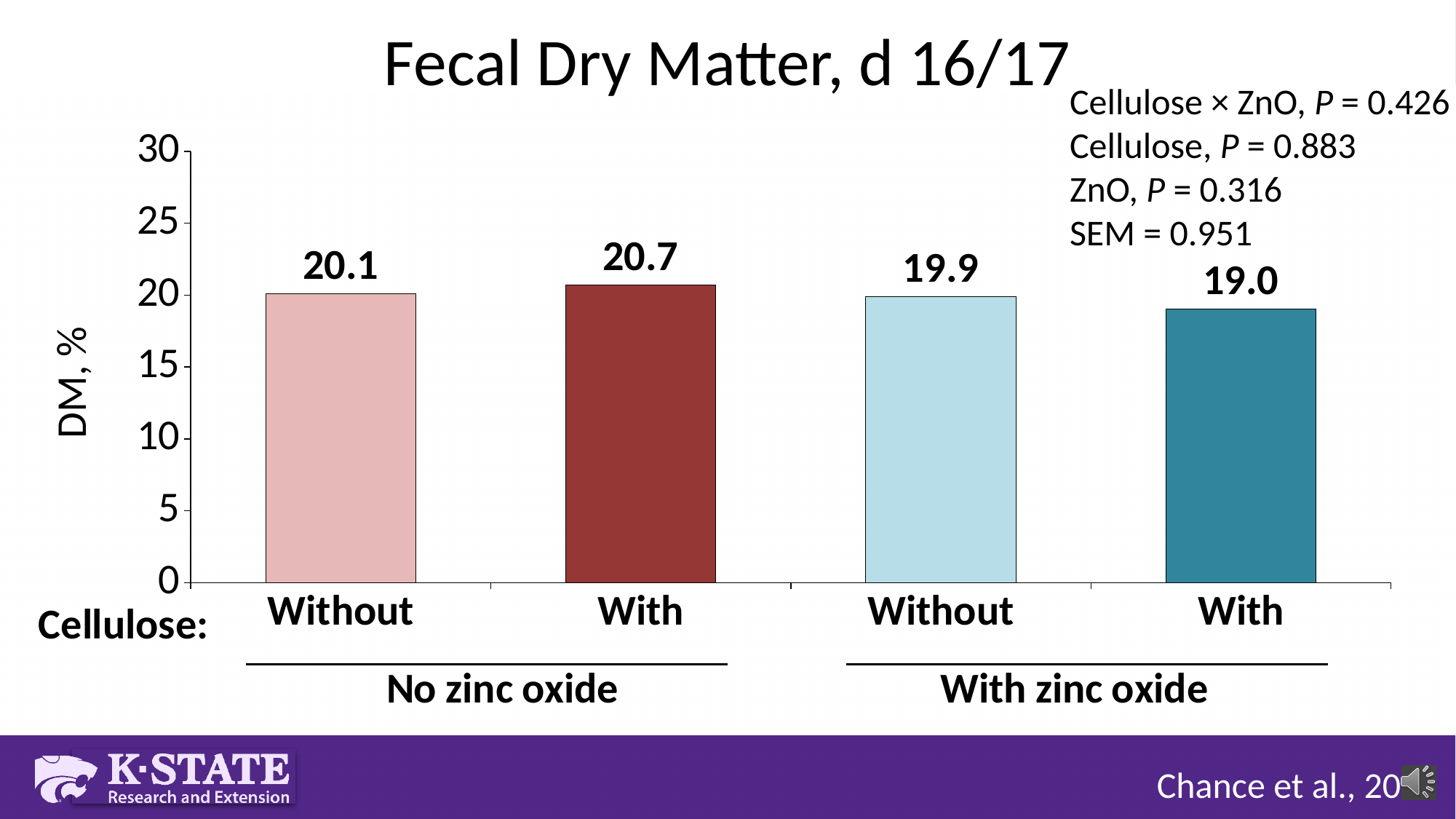
What is the fecal dry matter value for the Without cellulose bar in the No zinc oxide group? 20.1 What is the label of the y axis? DM, % How many bars are plotted in the chart? 4 What is the fecal dry matter value for the Without cellulose bar in the With zinc oxide group? 19.9 What is the fecal dry matter value for the With cellulose bar in the No zinc oxide group? 20.7 Which is larger: the With cellulose bar in the No zinc oxide group or the With cellulose bar in the With zinc oxide group? With cellulose, No zinc oxide What is the difference between the With cellulose and Without cellulose bars in the No zinc oxide group? 0.6 What kind of chart is shown on the slide? Bar chart What is the fecal dry matter value for the With cellulose bar in the With zinc oxide group? 19.0 Which bar has the lowest fecal dry matter value? With cellulose, With zinc oxide Which bar has the highest fecal dry matter value? With cellulose, No zinc oxide What is the difference between the Without cellulose and With cellulose bars in the With zinc oxide group? 0.9